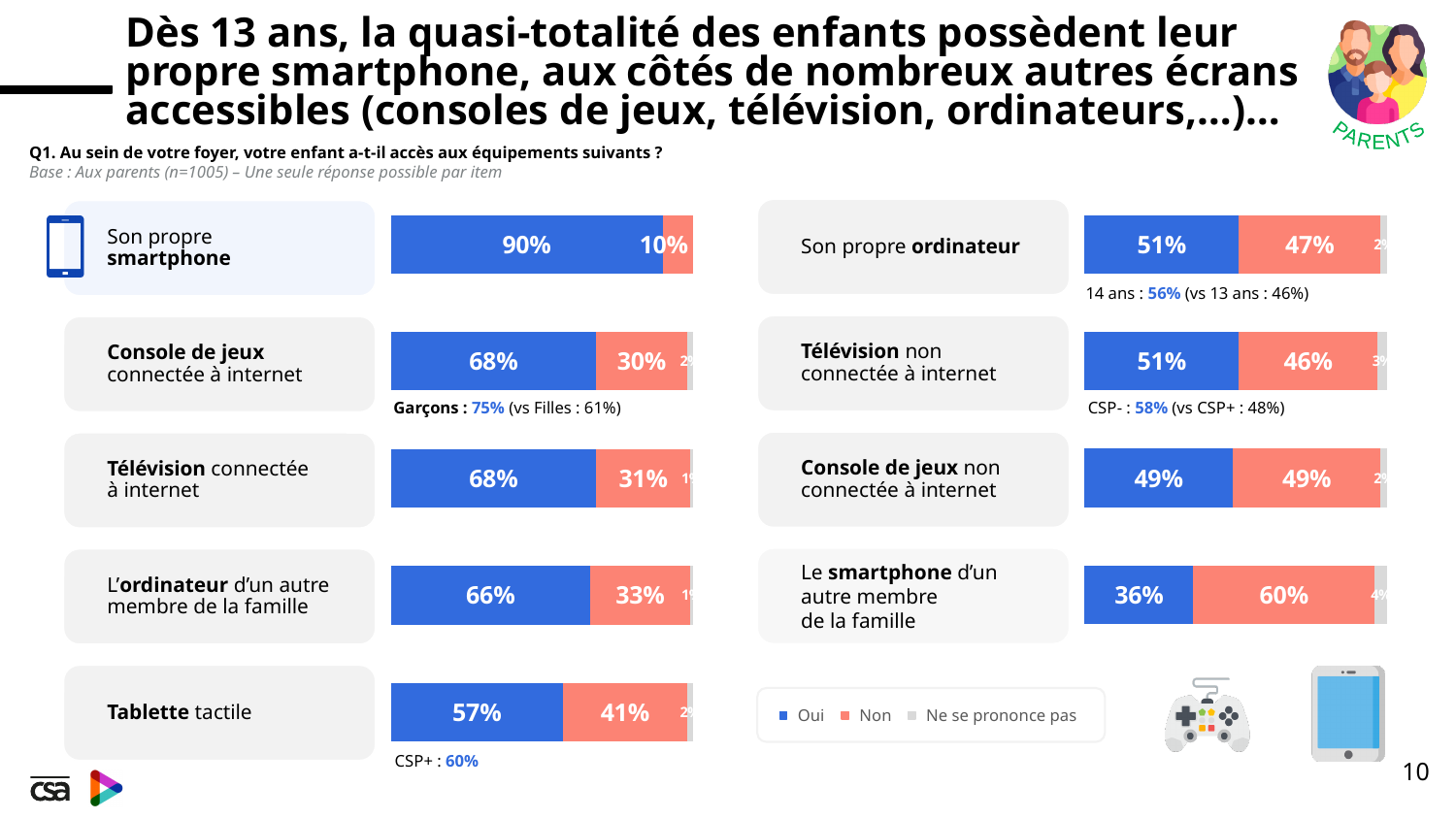
What kind of chart is used to show the responses for each equipment item? Stacked bar chart What percentage of parents answered "Oui" for "Son propre smartphone"? 90% Which equipment item has the lowest "Oui" percentage? Le smartphone d'un autre membre de la famille What is the "Oui" value for "Le smartphone d'un autre membre de la famille"? 36% What percentage of parents answered "Non" for "Tablette tactile"? 41% What is the "Non" value for "Son propre ordinateur"? 47% Which has a higher "Oui" value: "Console de jeux connectée à internet" or "Tablette tactile"? Console de jeux connectée à internet How many equipment items are shown with bars on the slide? 9 Is the "Oui" value for "Télévision connectée à internet" greater or less than 50%? greater How many series does the legend list? 3 What is the difference between the "Oui" and "Non" values for "Son propre smartphone"? 80% Which equipment item has the highest "Oui" percentage? Son propre smartphone